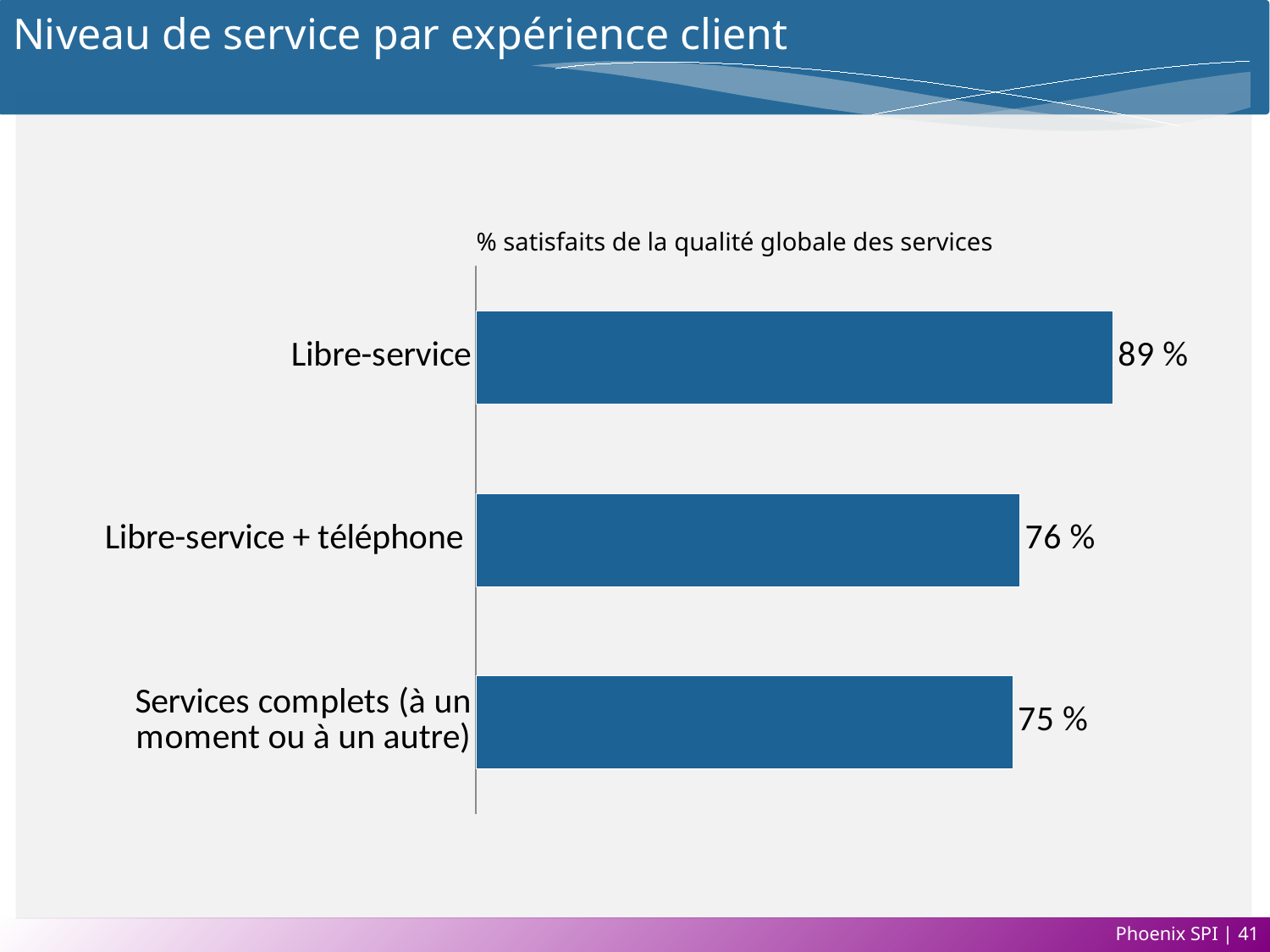
What kind of chart is shown on the slide? Bar chart What is the title of the chart? % satisfaits de la qualité globale des services What is the value for Libre-service? 89 % What is the value for Libre-service + téléphone? 76 % Which category has the lowest value? Services complets (à un moment ou à un autre) Which is larger, the value for Libre-service or the value for Services complets (à un moment ou à un autre)? Libre-service What colour are the bars in the chart? Blue What is the difference between the values for Libre-service + téléphone and Services complets (à un moment ou à un autre)? 1 % Which category has the highest value? Libre-service What is the value for Services complets (à un moment ou à un autre)? 75 % How many categories are shown in the chart? 3 What is the difference between the values for Libre-service and Libre-service + téléphone? 13 %